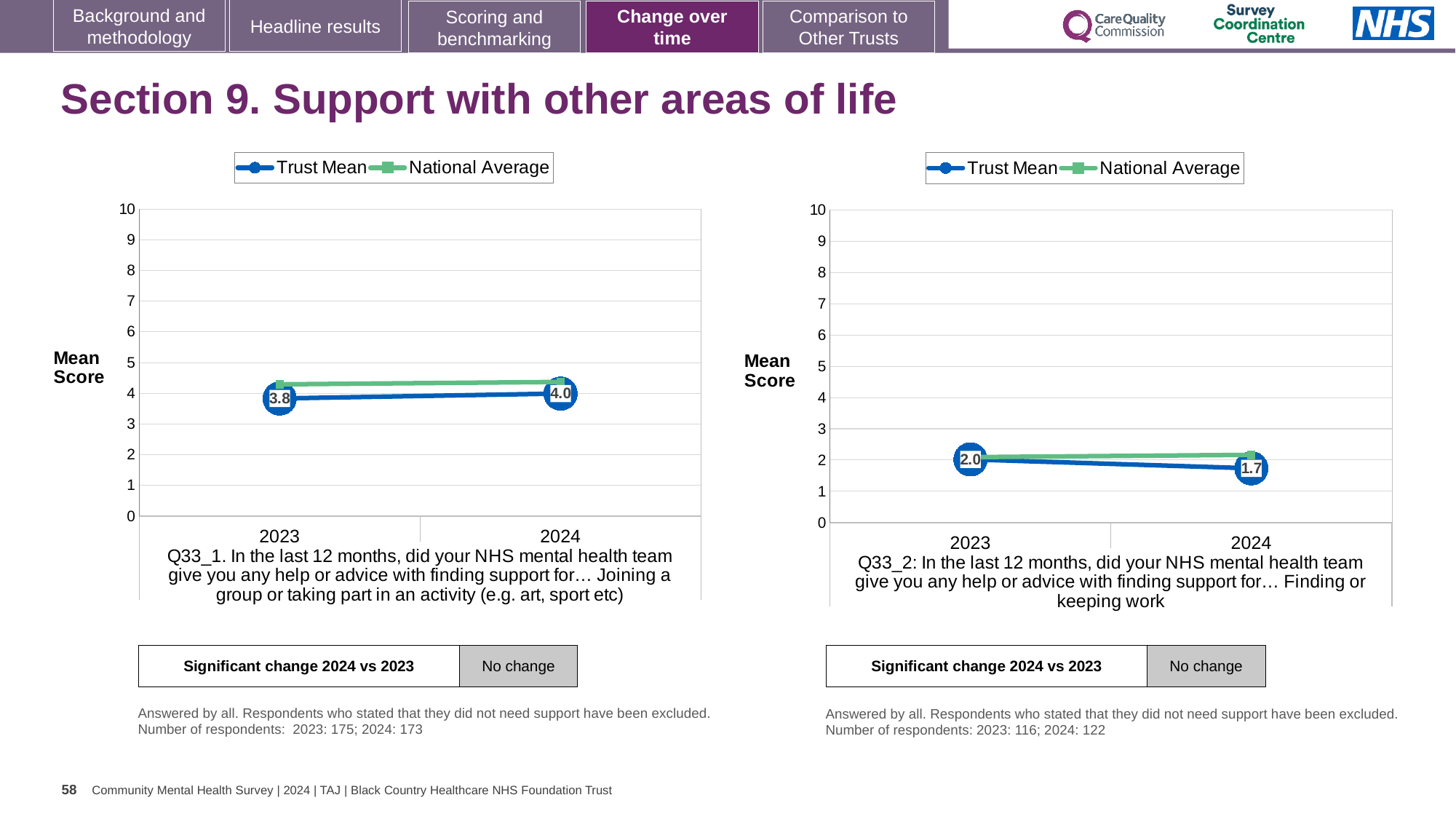
In the right chart (Q33_2), what is the Trust Mean score for 2023? 2.0 What kind of chart is the right chart (Q33_2)? line chart In the right chart (Q33_2), what is the difference between the Trust Mean in 2023 and 2024? 0.3 In the right chart (Q33_2), does the Trust Mean rise or fall from 2023 to 2024? fall In the left chart (Q33_1), what is the Trust Mean score for 2024? 4.0 In the right chart (Q33_2), is the National Average for 2024 greater or less than 1? greater In the right chart (Q33_2), what is the Trust Mean score for 2024? 1.7 In the left chart (Q33_1), which is higher in 2023, the Trust Mean or the National Average? National Average In the left chart (Q33_1), by how much did the Trust Mean change from 2023 to 2024? 0.2 In the left chart (Q33_1), what is the Trust Mean score for 2023? 3.8 In the left chart (Q33_1), does the Trust Mean rise or fall from 2023 to 2024? rise How many series does the legend of the left chart list? 2